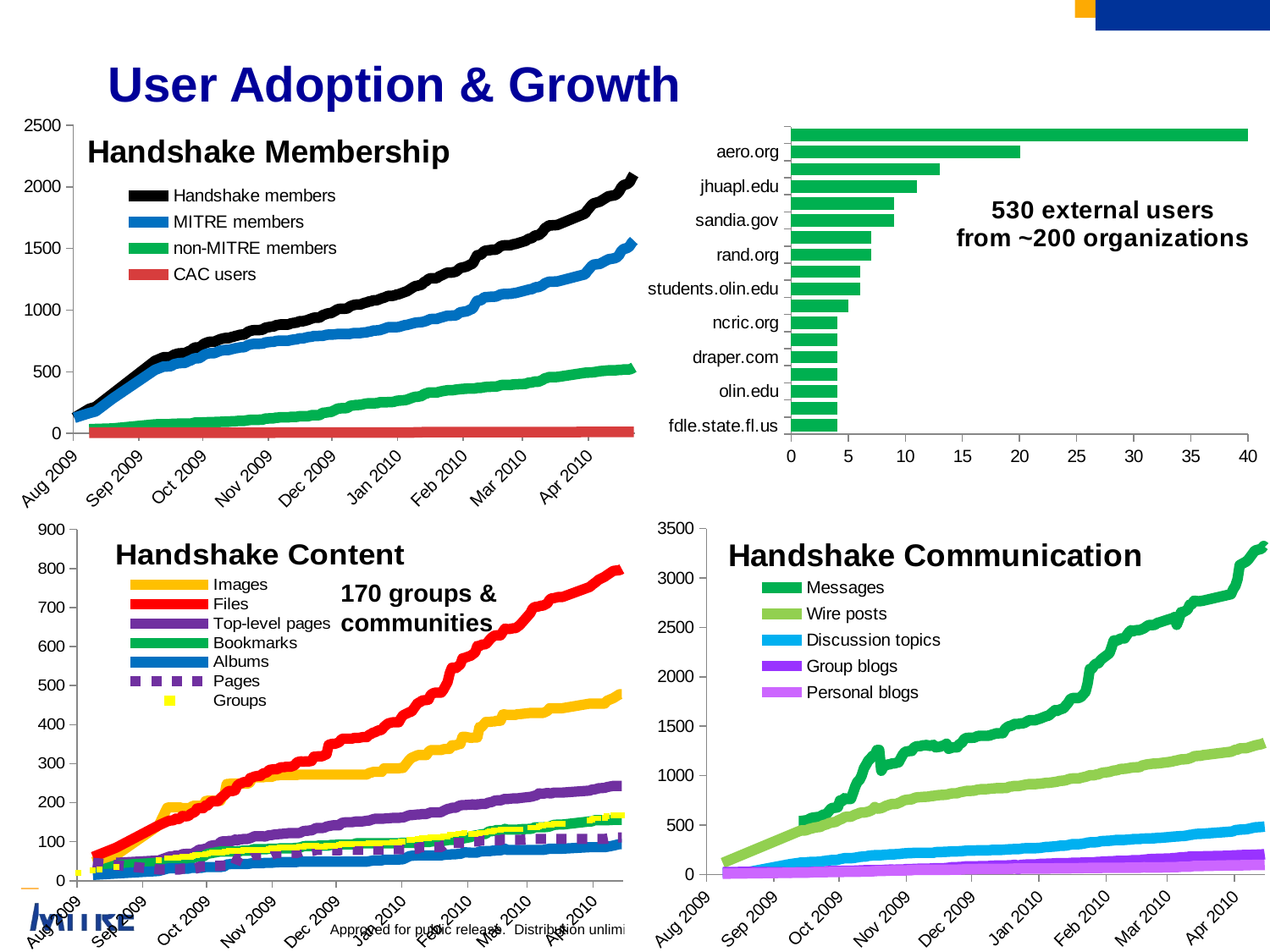
What kind of chart is the top-right chart listing organizations such as aero.org and jhuapl.edu? bar chart In the Handshake Content chart, which series has the highest value in Apr 2010? Files In the top-right bar chart, is the value for fdle.state.fl.us greater or less than 5? less In the top-right bar chart, what is the value for aero.org? 20 In the Handshake Membership chart, is the value for Handshake members in Apr 2010 greater or less than 1500? greater How many series does the legend of the Handshake Membership chart list? 4 What kind of chart is the Handshake Membership chart? line chart How many series does the legend of the Handshake Content chart list? 7 In the Handshake Membership chart, do Handshake members rise or fall from Aug 2009 to Apr 2010? rise In the Handshake Membership chart, which series has the lowest values throughout? CAC users In the top-right bar chart, which is larger, aero.org or jhuapl.edu? aero.org